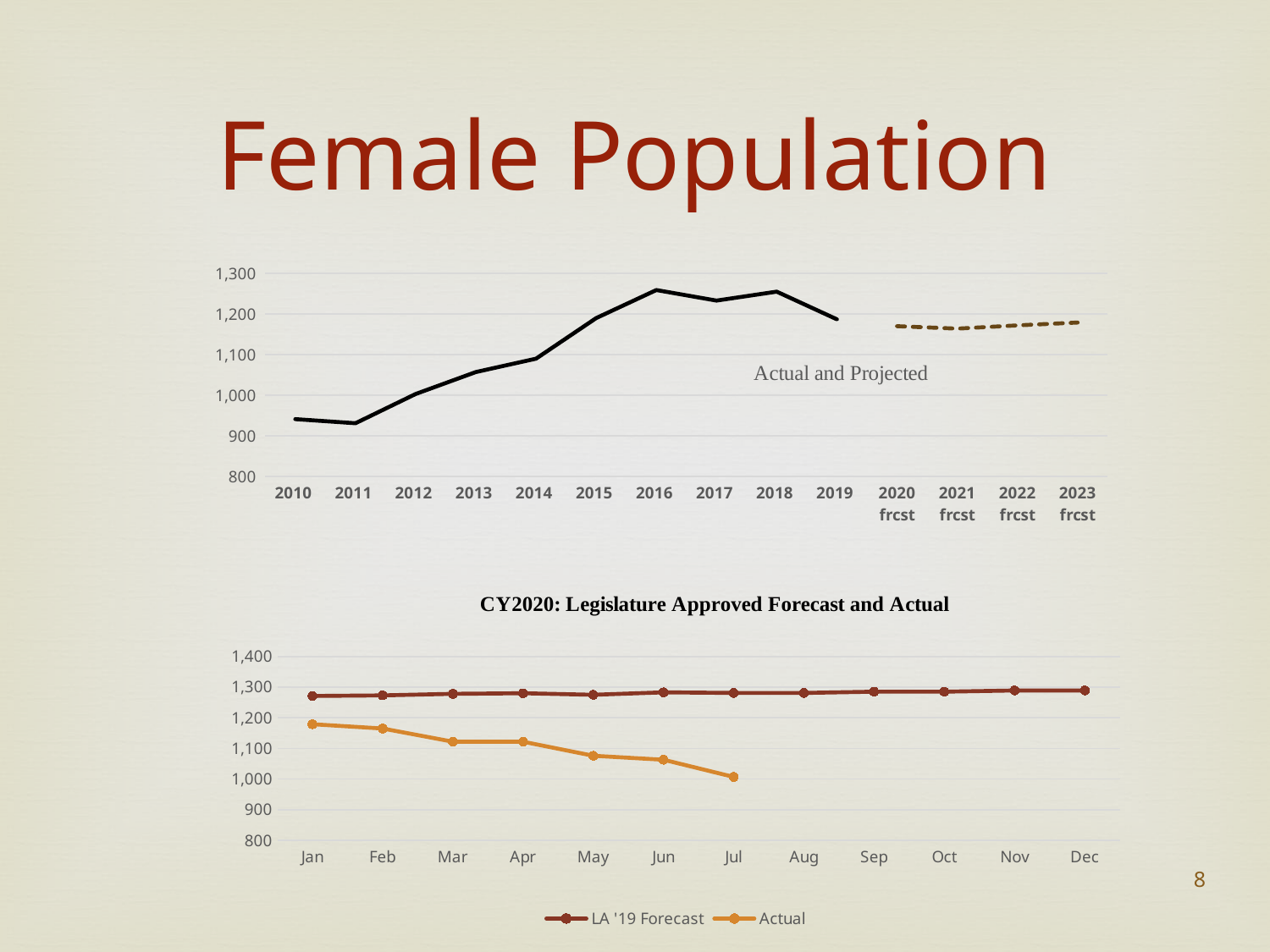
What kind of chart is the top chart, 'Actual and Projected'? line chart In the bottom chart, 'CY2020: Legislature Approved Forecast and Actual', which series is larger in Jan, LA '19 Forecast or Actual? LA '19 Forecast In the bottom chart, 'CY2020: Legislature Approved Forecast and Actual', is the Actual value for Jul greater or less than 1,100? less In the top chart, 'Actual and Projected', which is larger, the value for 2010 or the value for 2019? 2019 In the top chart, 'Actual and Projected', is the value for 2023 frcst greater or less than 1,200? less How many categories are shown on the x axis of the top chart, 'Actual and Projected'? 14 In the top chart, 'Actual and Projected', is the value for 2010 greater or less than 1,000? less In the bottom chart, 'CY2020: Legislature Approved Forecast and Actual', which month has the lowest Actual value? Jul In the top chart, 'Actual and Projected', do the values rise or fall from 2011 to 2016? rise In the bottom chart, 'CY2020: Legislature Approved Forecast and Actual', do the Actual values rise or fall from Jan to Jul? fall How many series does the legend list in the bottom chart, 'CY2020: Legislature Approved Forecast and Actual'? 2